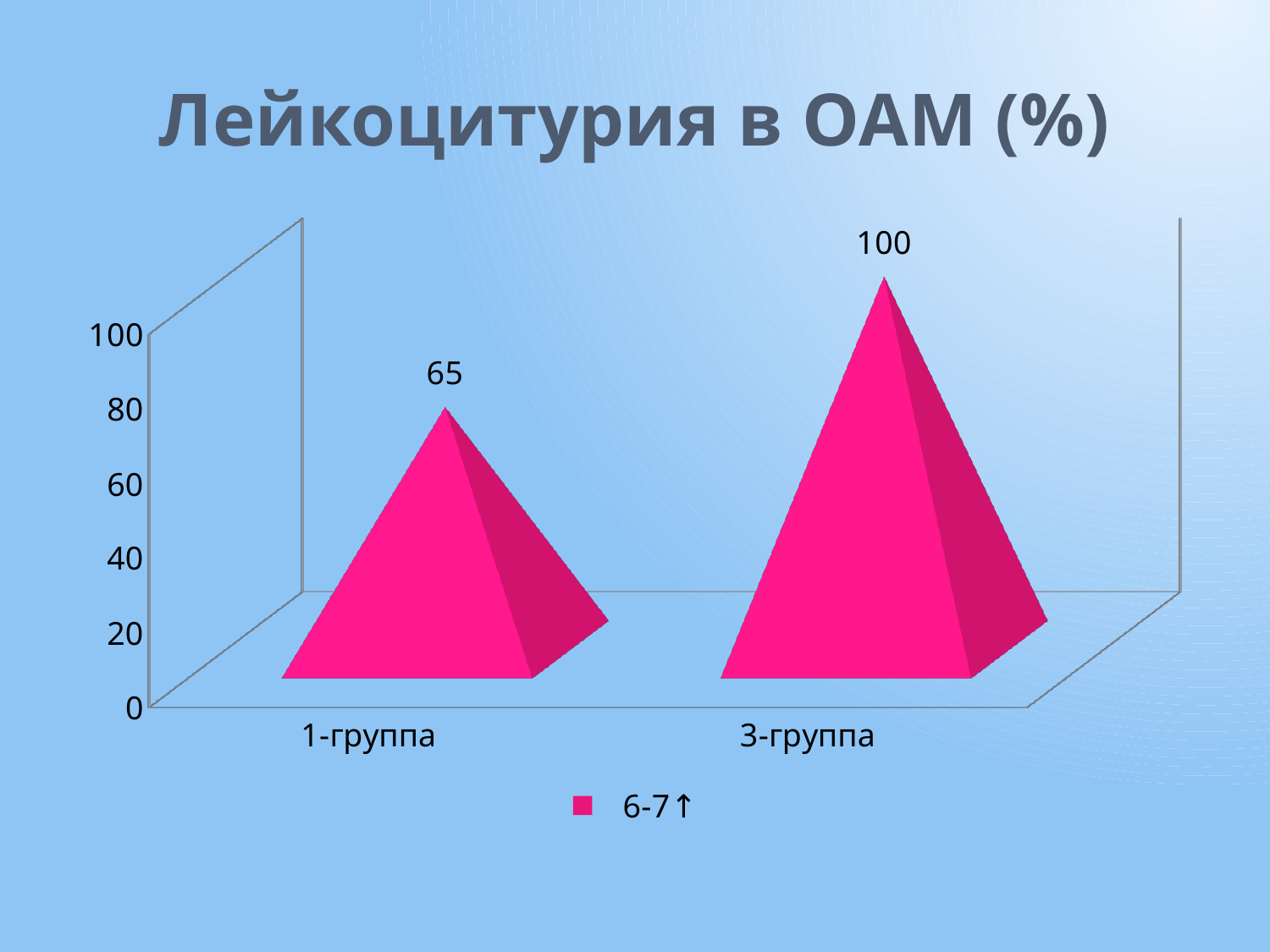
What kind of chart is shown on the slide? bar chart How many series does the legend list? 1 What is the title of the chart? Лейкоцитурия в ОАМ (%) How many categories are shown on the x axis? 2 Which category has the lowest value? 1-группа What is the difference between the values for 3-группа and 1-группа? 35 What is the legend entry for the series? 6-7↑ What is the value for 1-группа? 65 Which is larger, the value for 1-группа or the value for 3-группа? 3-группа What is the value for 3-группа? 100 Which category has the highest value? 3-группа Is the value for 1-группа greater or less than 80? less